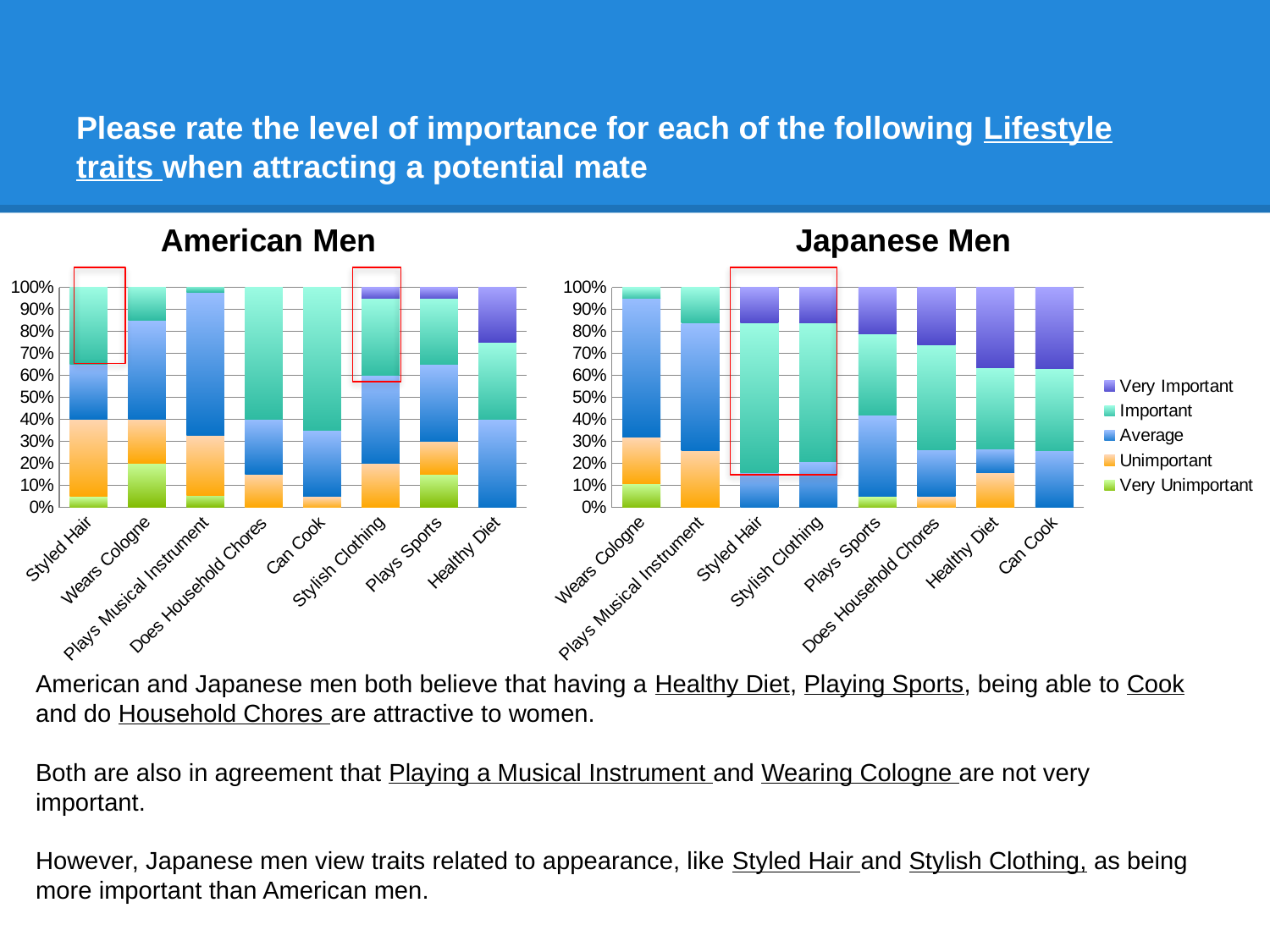
Which legend entry is shown in purple? Very Important In the American Men chart, is the Very Important share for Healthy Diet greater or less than 20%? greater In the Japanese Men chart, is the Very Important share for Can Cook greater or less than 30%? greater What are the titles of the two charts on the slide? American Men and Japanese Men How many series does the legend list? 5 How many categories are shown on the x axis of the Japanese Men chart? 8 In the Japanese Men chart, is the Average share for Wears Cologne greater or less than 50%? greater In the Japanese Men chart, which has the larger Very Important segment: Can Cook or Wears Cologne? Can Cook What kind of chart is the American Men chart? Stacked bar chart In the American Men chart, which category has the largest Unimportant segment? Styled Hair In the American Men chart, which category has the largest Very Important segment? Healthy Diet